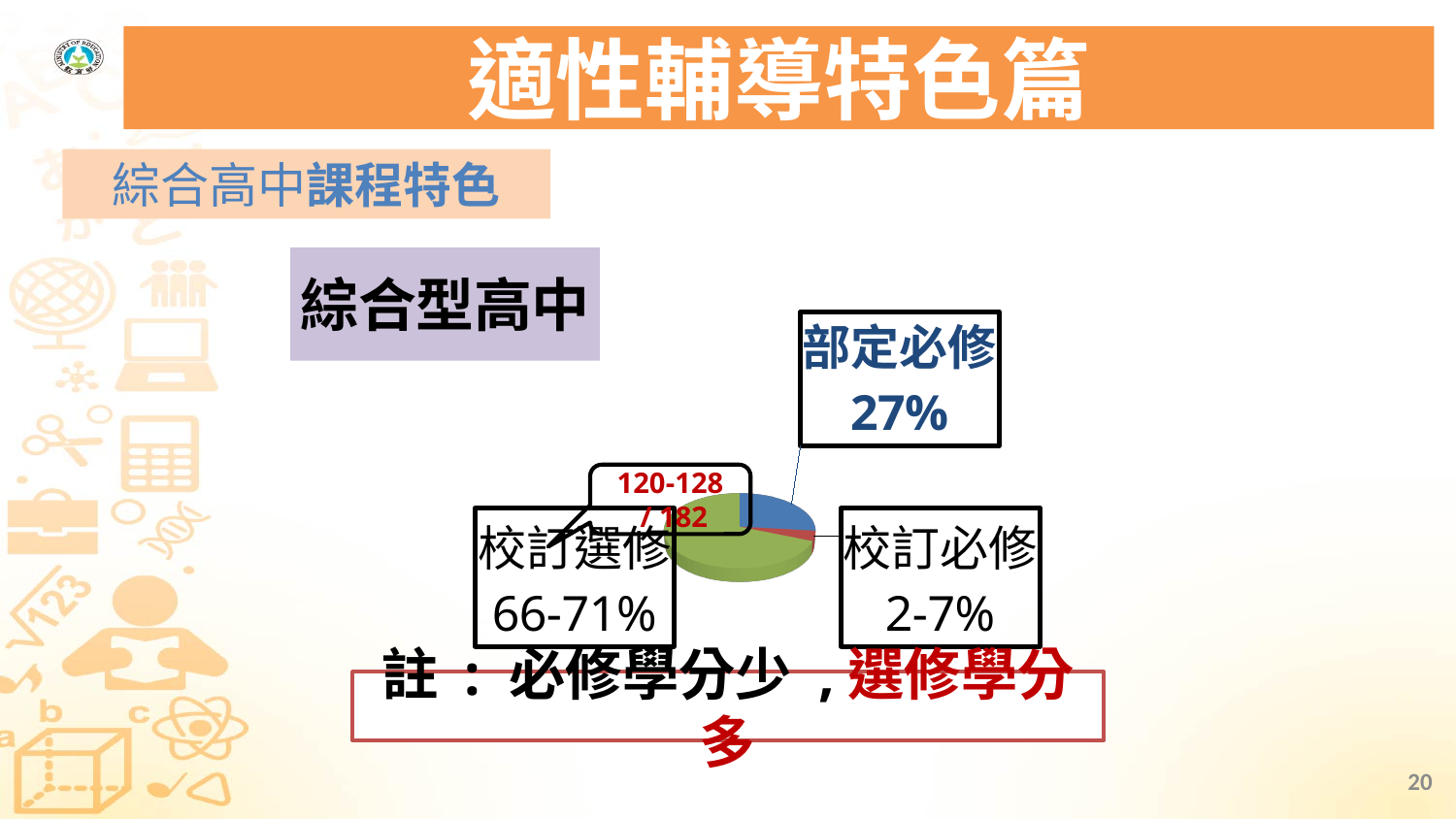
Which category has the smallest slice of the pie chart? 校訂必修 Which is larger in the pie chart, 校訂選修 or 部定必修? 校訂選修 What percentage is shown for 部定必修 in the pie chart? 27% What kind of chart is shown on the slide? pie chart Which category has the largest slice of the pie chart? 校訂選修 How many slices does the pie chart have? 3 What percentage range is shown for 校訂選修 in the pie chart? 66-71% Is the share for 部定必修 greater or less than 50%? less What colour is the 校訂選修 slice of the pie chart? green What credit figure is shown in the callout attached to the 校訂選修 slice? 120-128 / 182 Which is larger in the pie chart, 部定必修 or 校訂必修? 部定必修 What percentage range is shown for 校訂必修 in the pie chart? 2-7%